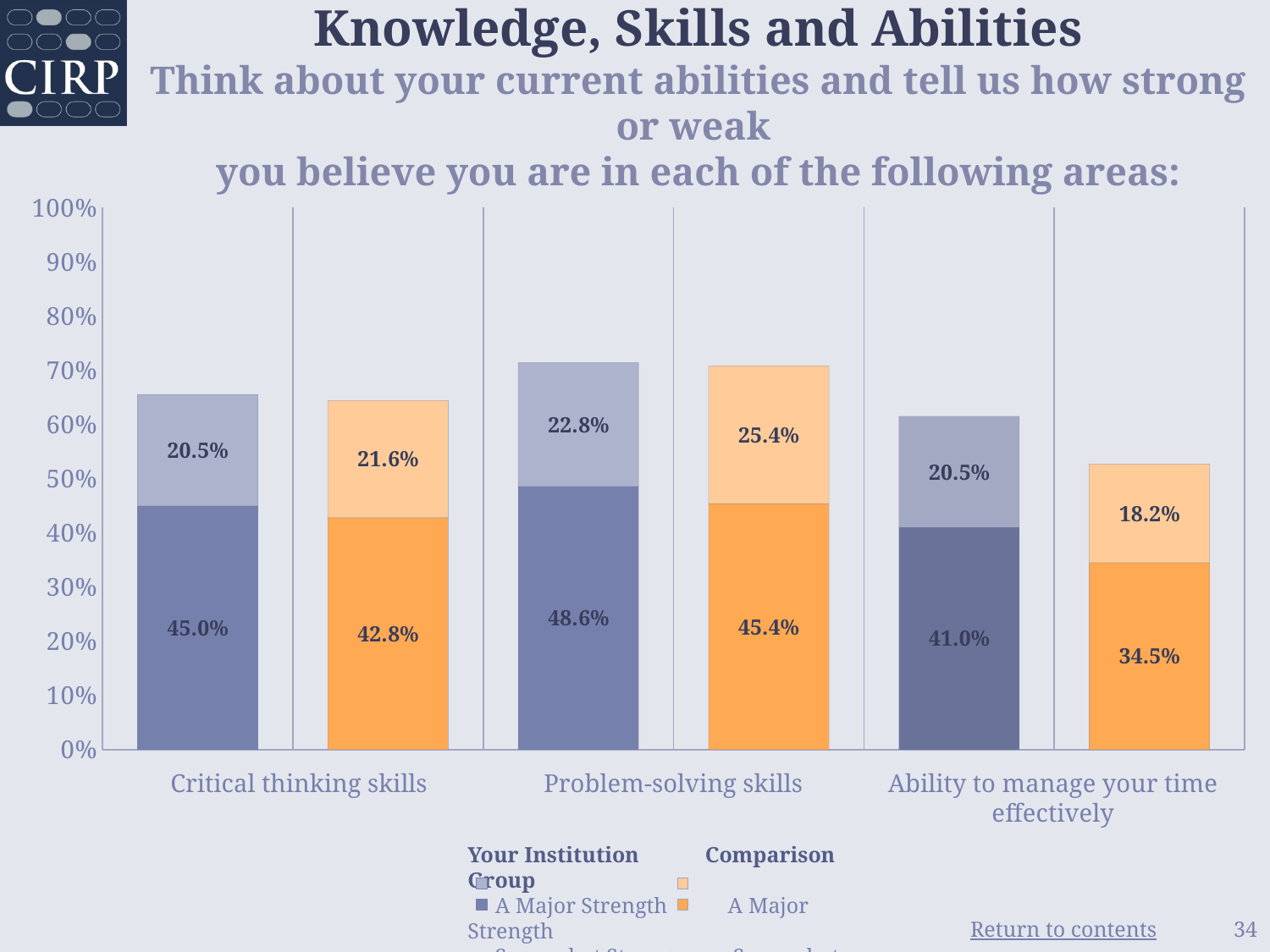
Which category has the highest 'A Major Strength' percentage for Your Institution? Problem-solving skills What is the total height of the Your Institution stacked bar for Critical thinking skills? 65.5% What is the value of the lighter top segment of the Comparison Group bar for Ability to manage your time effectively? 18.2% What percentage of Your Institution respondents rated Critical thinking skills as 'A Major Strength'? 45.0% For Critical thinking skills, which is larger: the Your Institution 'A Major Strength' value or the Comparison Group 'A Major Strength' value? Your Institution What is the value of the lighter top segment of the Your Institution bar for Problem-solving skills? 22.8% What is the total height of the Comparison Group stacked bar for Ability to manage your time effectively? 52.7% What percentage of the Comparison Group rated Problem-solving skills as 'A Major Strength'? 45.4% How many skill categories are shown on the x axis? 3 What is the difference between the Your Institution and Comparison Group 'A Major Strength' percentages for Ability to manage your time effectively? 6.5% Which category has the lowest 'A Major Strength' percentage for the Comparison Group? Ability to manage your time effectively What type of chart is shown on the slide? Stacked bar chart